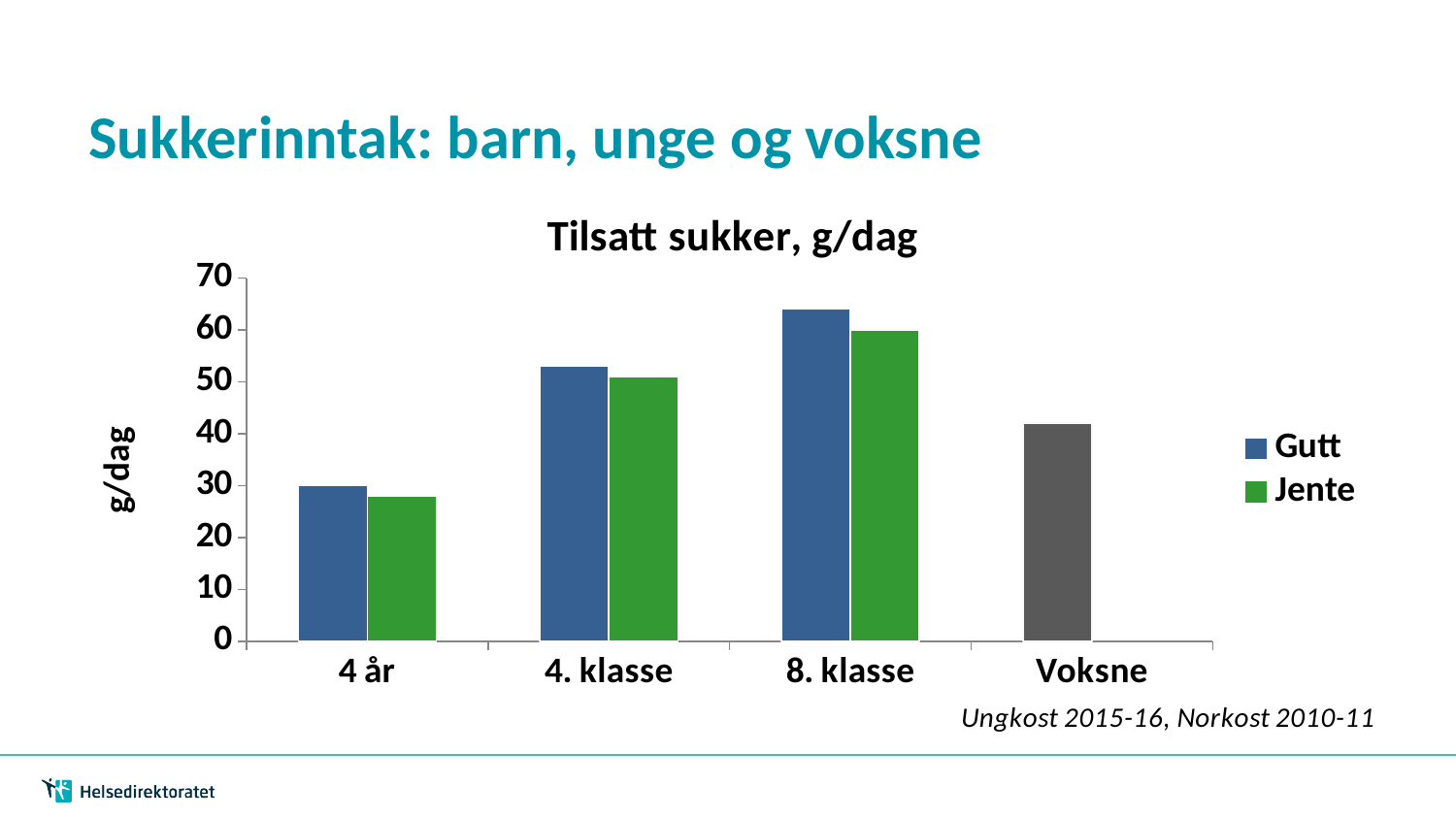
Which is larger, the value for Voksne or the value for Jente in 4. klasse? Jente in 4. klasse Is the value for Jente at 4 år greater or less than 40? less Is the value for Gutt in 8. klasse greater or less than 60? greater How many series does the legend list? 2 Is the value for Voksne greater or less than 50? less What kind of chart is shown on the slide? bar chart Which bar is the highest in the chart? Gutt, 8. klasse How many categories are shown on the x axis? 4 Which bar is the lowest in the chart? Jente, 4 år In 8. klasse, which is larger, Gutt or Jente? Gutt What is the title of the chart? Tilsatt sukker, g/dag